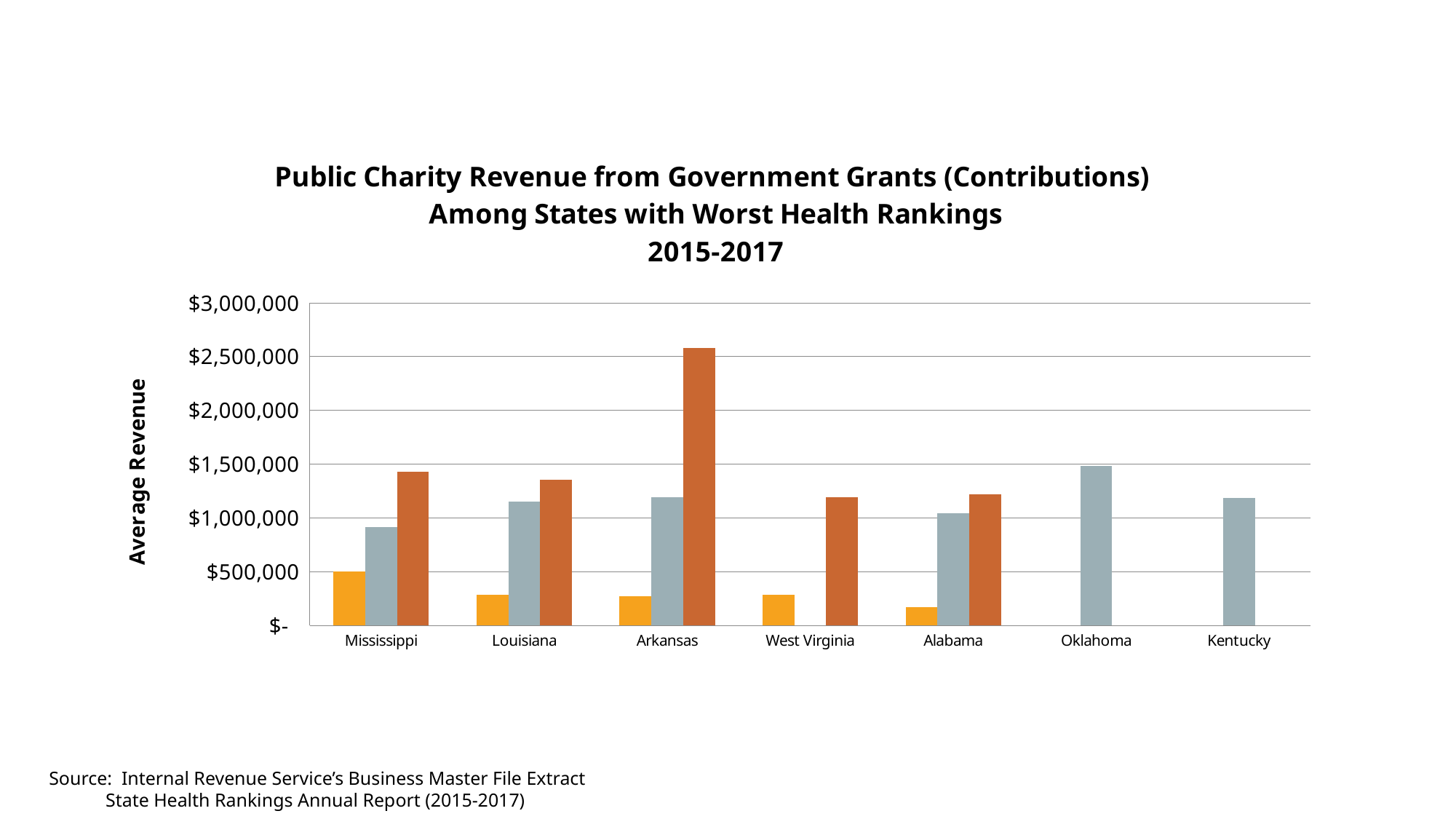
What kind of chart is shown on the slide? Bar chart Is the dark orange bar for Arkansas greater or less than $2,000,000? greater Which state has the shortest yellow bar? Alabama Which state has the tallest grey bar? Oklahoma Is the grey bar for Kentucky greater or less than $1,000,000? greater Which is larger, the grey bar for Oklahoma or the grey bar for Kentucky? Oklahoma Is the yellow bar for West Virginia greater or less than $500,000? less Which is larger, the dark orange bar for Arkansas or the dark orange bar for Mississippi? Arkansas Which state has the tallest bar in the chart? Arkansas How many states are shown on the x axis of the chart? 7 What is the label on the vertical axis of the chart? Average Revenue